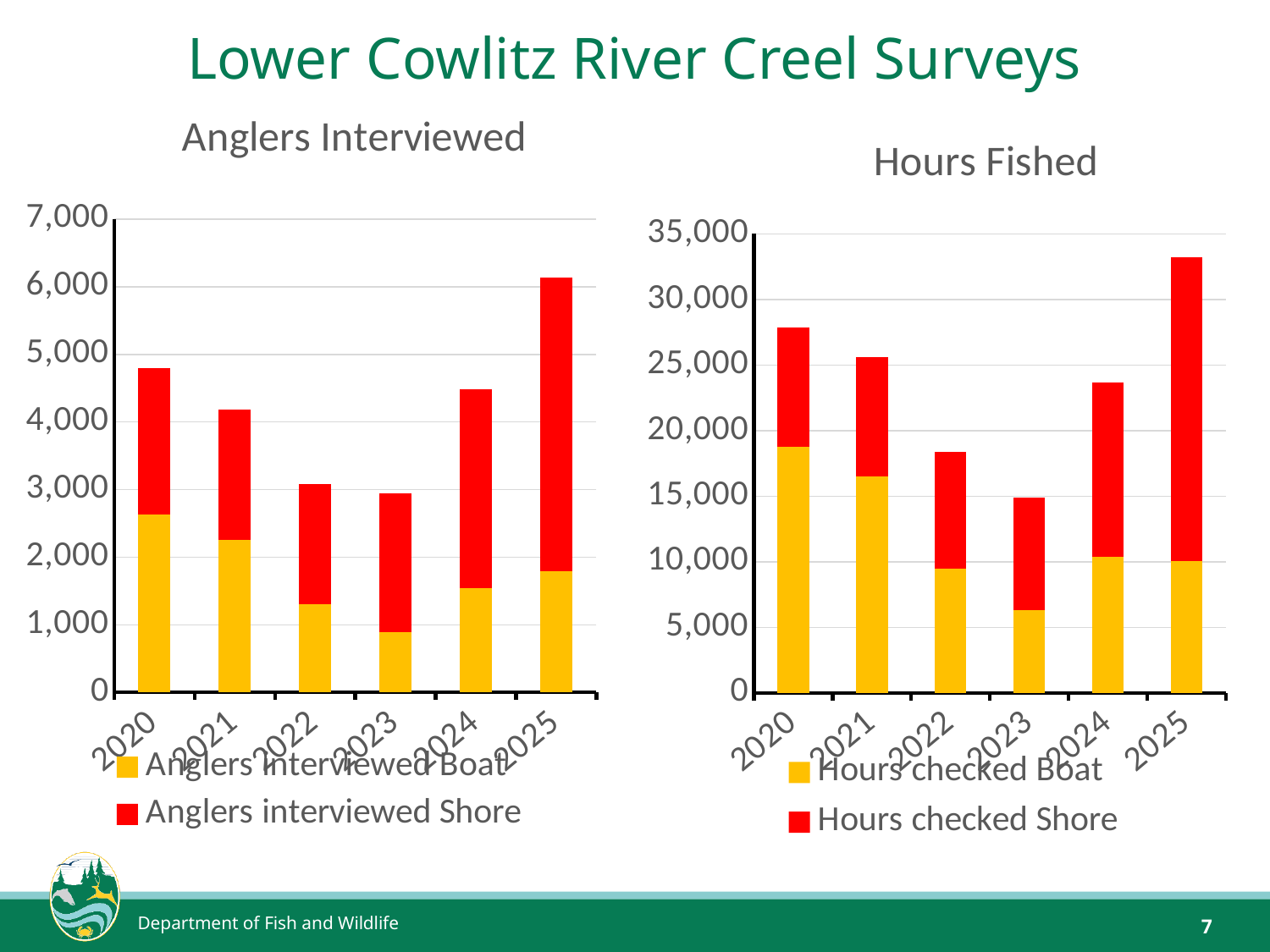
In the Anglers Interviewed chart, is the total bar for 2025 greater or less than 6,000? greater In the Anglers Interviewed chart, which is larger, the total bar for 2020 or the total bar for 2021? 2020 How many years are shown on the x axis of the Anglers Interviewed chart? 6 In the Hours Fished chart, which year has the tallest stacked bar? 2025 In the Hours Fished chart, is the total bar for 2020 greater or less than 25,000? greater In the Hours Fished chart, which year has the shortest stacked bar? 2023 How many series does the legend of the Hours Fished chart list? 2 In the Hours Fished chart, is the Hours checked Boat segment for 2023 greater or less than 10,000? less In the Anglers Interviewed chart, which year has the tallest stacked bar? 2025 What type of chart is the Anglers Interviewed chart? Stacked bar chart In the Hours Fished chart, which is larger, the Hours checked Boat segment for 2020 or for 2022? 2020